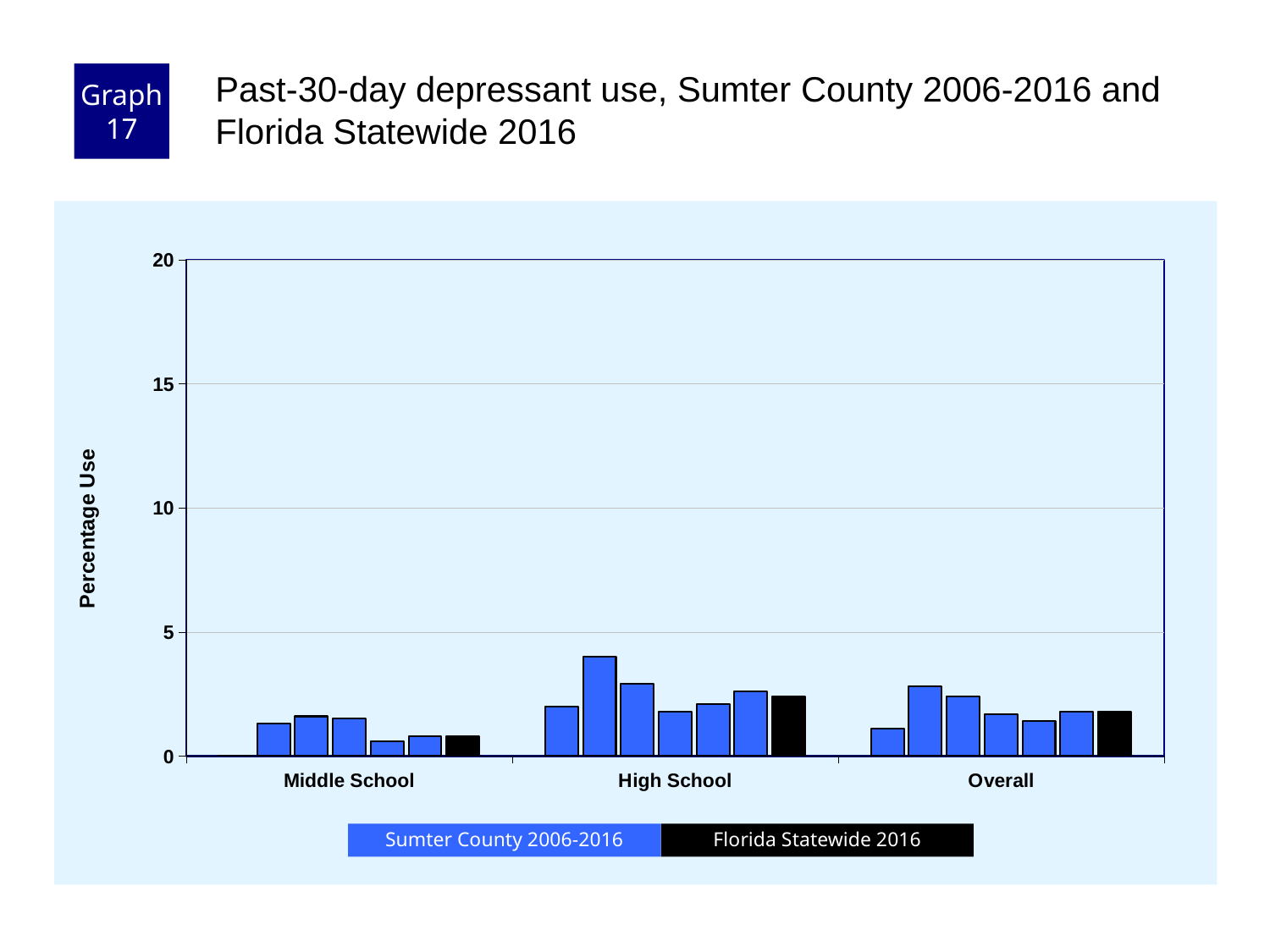
How many series does the legend list? 2 Which is larger, the Florida Statewide 2016 value for High School or for Middle School? High School Is the Florida Statewide 2016 value for Middle School greater or less than 5? less What is the label on the y axis? Percentage Use Is the Florida Statewide 2016 value for High School greater or less than 5? less Which category contains the tallest bar in the chart? High School How many school-level categories are shown on the x axis? 3 Is the tallest Sumter County 2006-2016 bar for High School greater or less than 5? less Which is larger, the Florida Statewide 2016 value for Overall or for Middle School? Overall Which series is shown in black in the legend? Florida Statewide 2016 What kind of chart is shown on the slide? bar chart